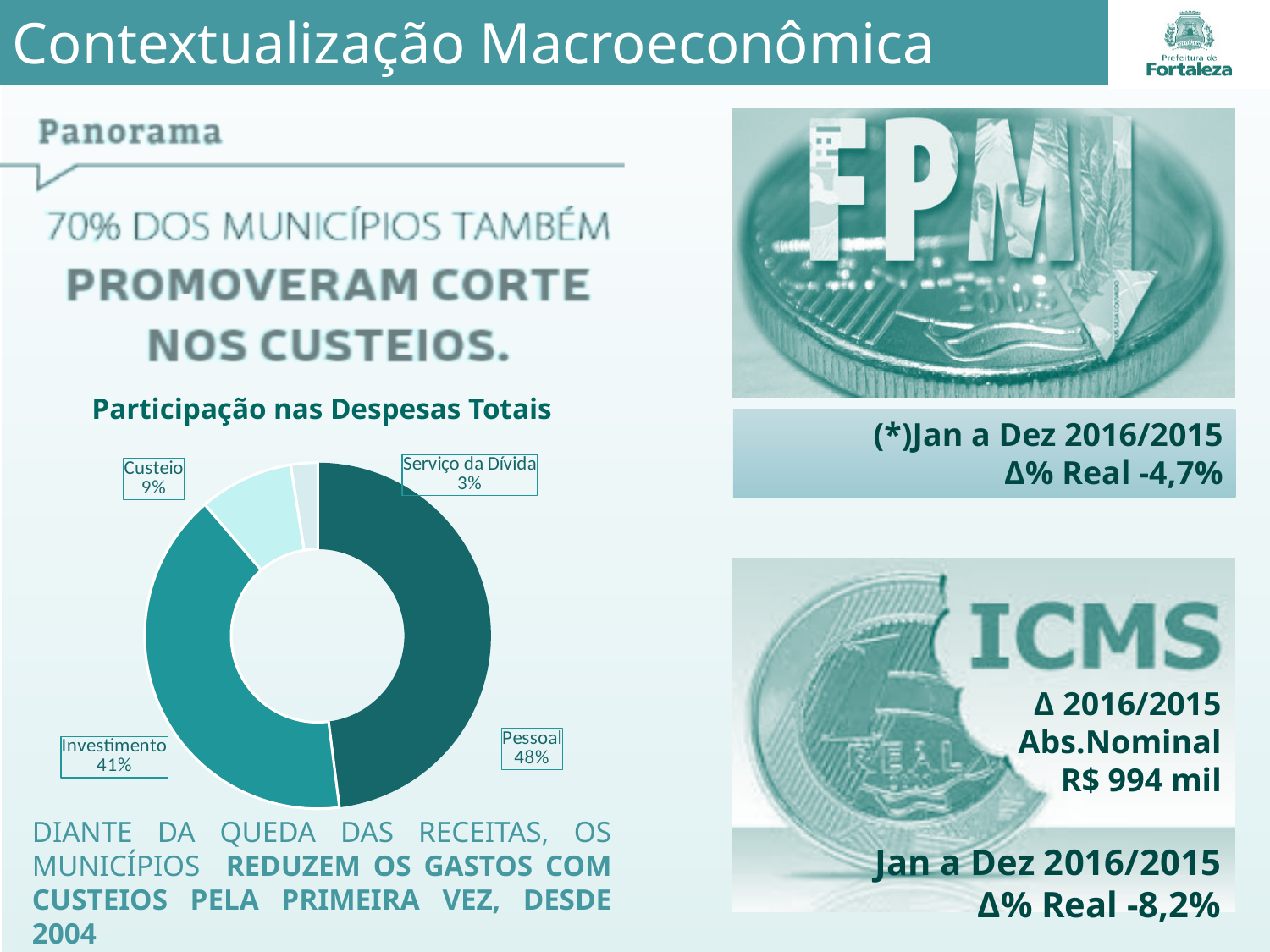
What type of chart is 'Participação nas Despesas Totais'? Doughnut (pie) chart Which category has the smallest share in the 'Participação nas Despesas Totais' chart? Serviço da Dívida What share of total expenses does Investimento represent in the 'Participação nas Despesas Totais' chart? 41% What is the title of the chart on the slide? Participação nas Despesas Totais How many categories are shown in the 'Participação nas Despesas Totais' chart? 4 What share of total expenses does Custeio represent in the 'Participação nas Despesas Totais' chart? 9% What share of total expenses does Serviço da Dívida represent in the 'Participação nas Despesas Totais' chart? 3% What share of total expenses does Pessoal represent in the 'Participação nas Despesas Totais' chart? 48% In the 'Participação nas Despesas Totais' chart, which is larger: Custeio or Serviço da Dívida? Custeio In the 'Participação nas Despesas Totais' chart, what is the combined share of Custeio and Serviço da Dívida? 12% In the 'Participação nas Despesas Totais' chart, what is the difference in percentage points between Pessoal and Investimento? 7 percentage points Which category has the largest share in the 'Participação nas Despesas Totais' chart? Pessoal